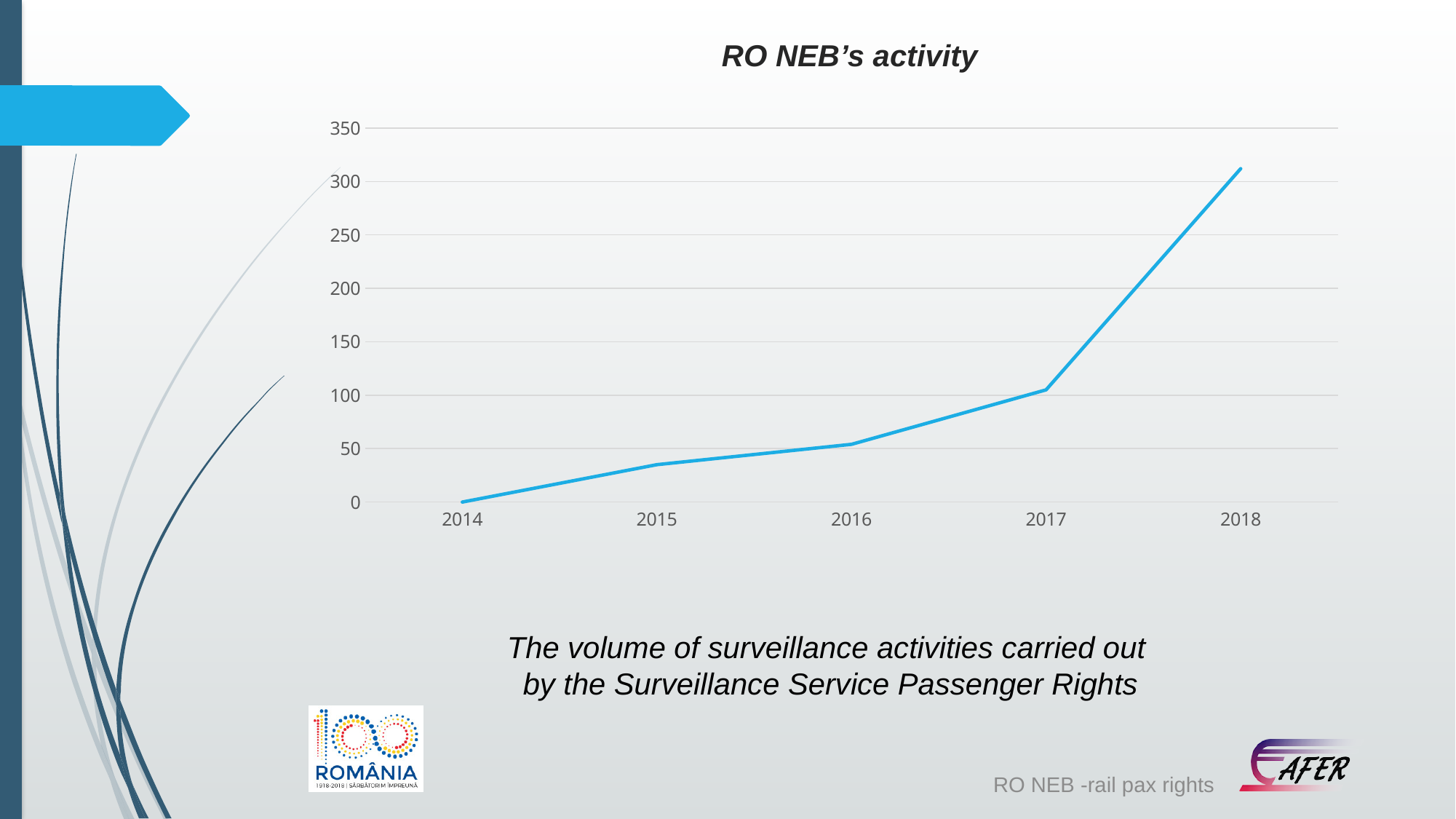
Which year has the lowest value? 2014 What kind of chart is shown on the slide? line chart Is the value for 2017 greater or less than 150? less Is the value for 2015 greater or less than 50? less How many years are plotted on the x axis? 5 Is the value for 2018 greater or less than 300? greater Which year has the larger value, 2015 or 2016? 2016 What is the title of the chart? RO NEB's activity Do the values rise or fall from 2014 to 2018? rise Which year has the highest value? 2018 Which year has the larger value, 2017 or 2018? 2018